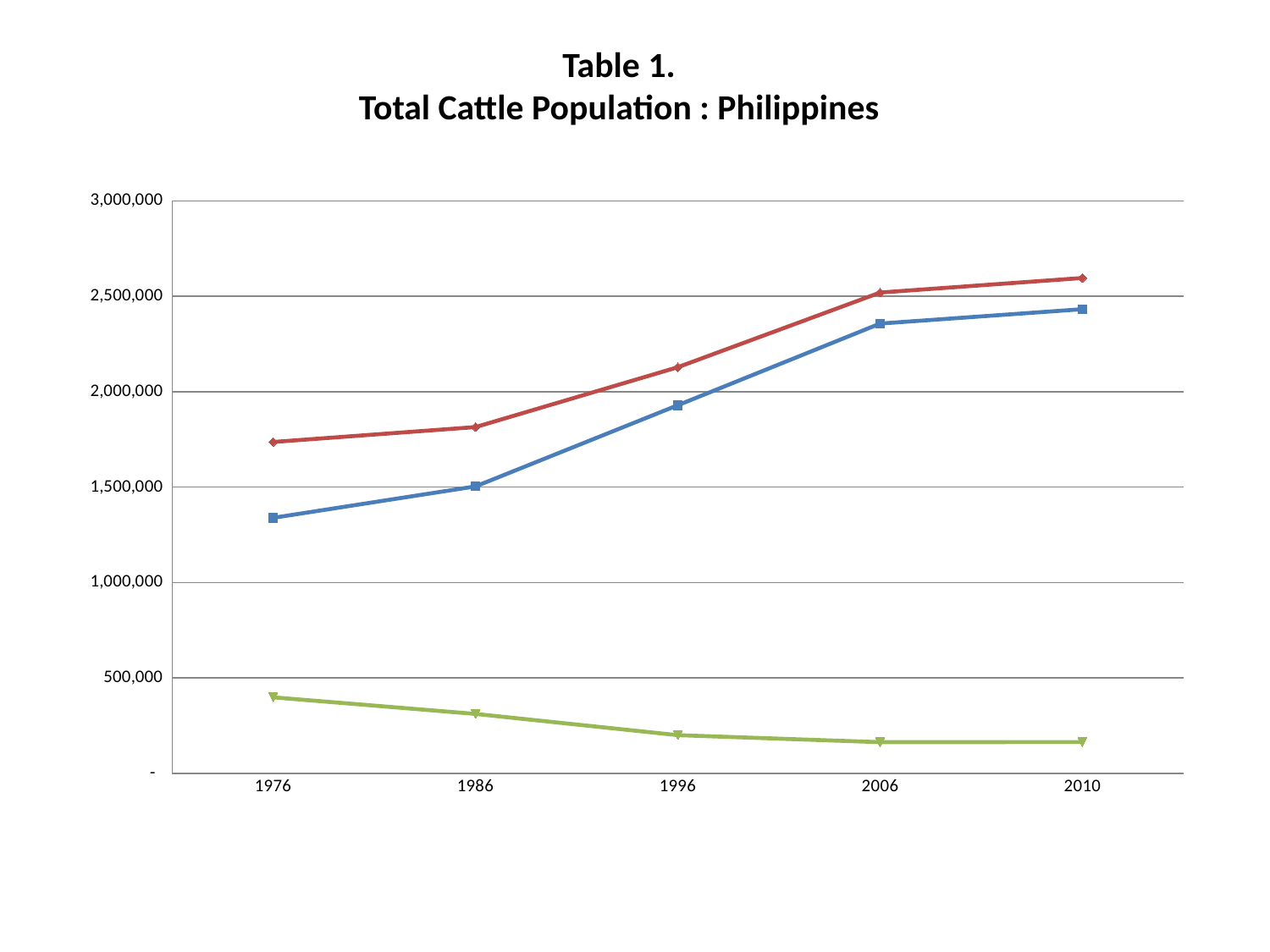
In 1996, which line has the higher value, the red line or the blue line? red line Is the value of the blue line in 1976 greater or less than 1,500,000? less Does the green line rise or fall from 1976 to 2010? fall Does the red line rise or fall from 1976 to 2010? rise How many years are plotted along the x axis? 5 How many lines are plotted on the chart? 3 What kind of chart is shown on the slide? line chart Is the value of the red line in 2010 greater or less than 2,500,000? greater In which year does the blue line reach its highest value? 2010 In which year does the green line have its highest value? 1976 Is the value of the green line in 2006 greater or less than 500,000? less What is the title of the chart? Table 1. Total Cattle Population : Philippines